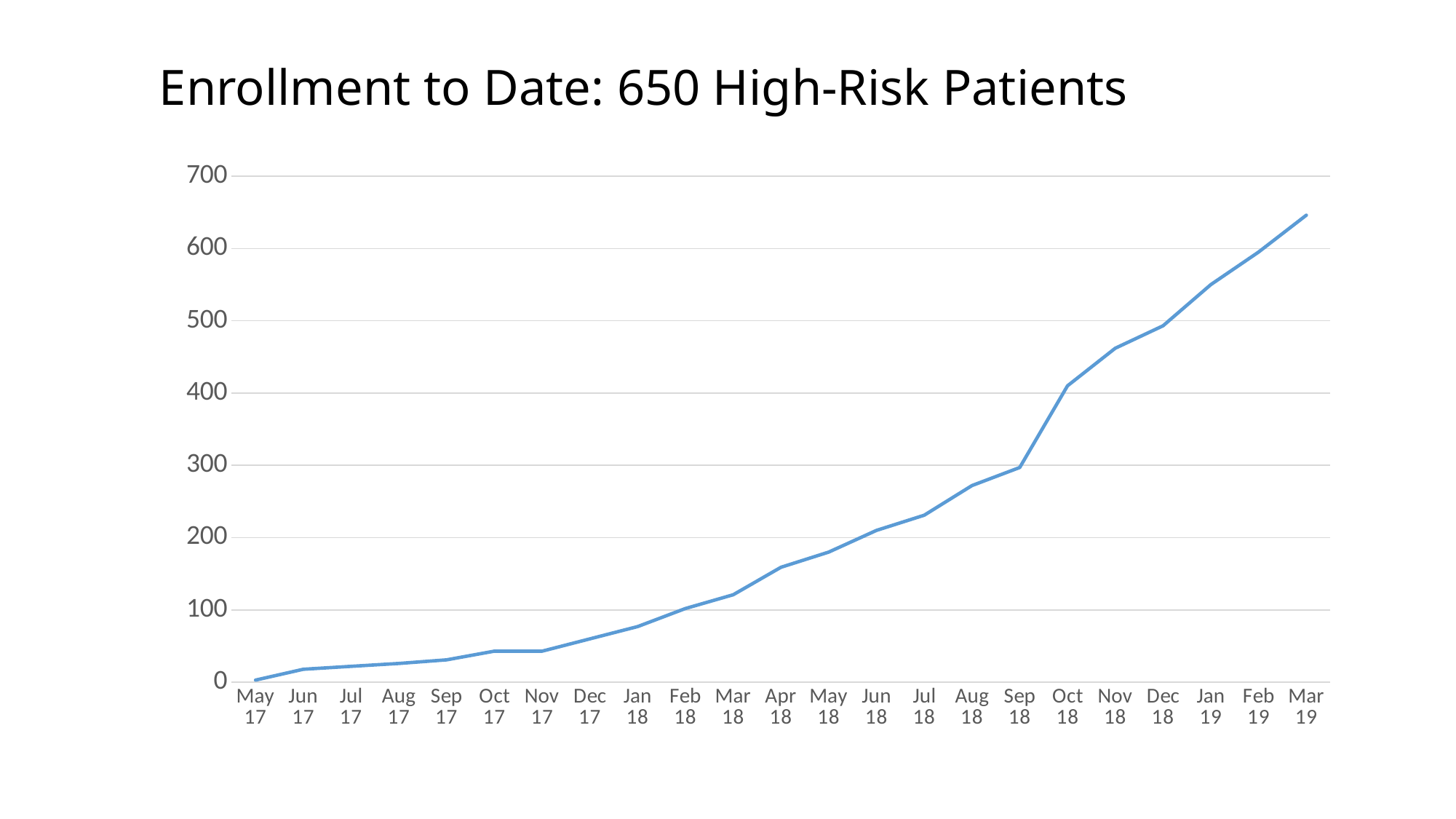
What kind of chart is shown on the slide? line chart Which month has the lowest value? May 17 Which is larger, the value for Sep 18 or the value for Oct 18? Oct 18 Is the value for Dec 17 greater or less than 100? less Do the values rise or fall from May 17 to Mar 19? rise What is the title of the chart on the slide? Enrollment to Date: 650 High-Risk Patients How many months are plotted along the x axis? 23 Is the value for Nov 18 greater or less than 500? less Which month has the highest value? Mar 19 Is the value for Mar 19 greater or less than 600? greater